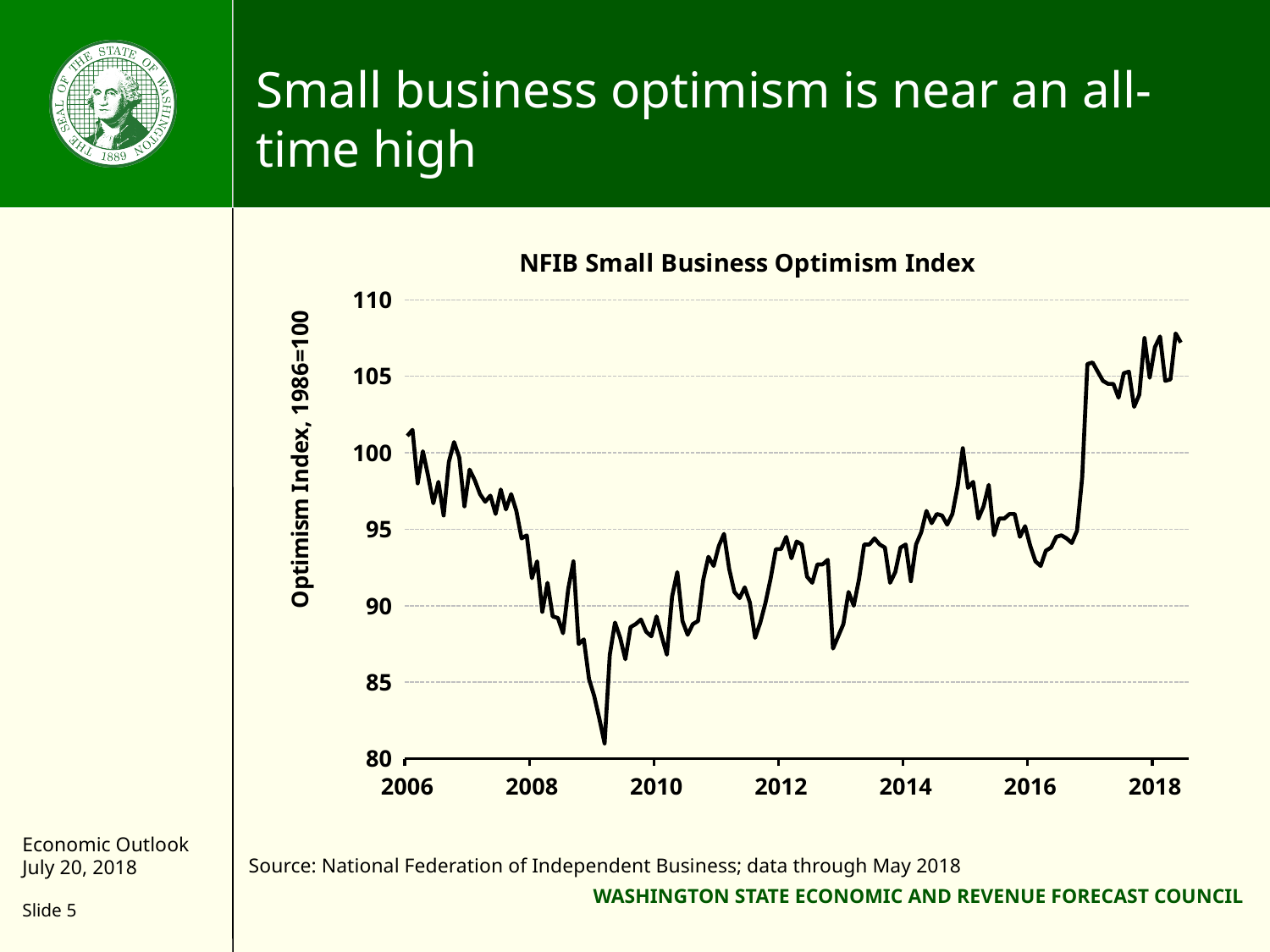
How many lines are plotted on the chart? 1 Is the value of the index at the start of 2016 greater or less than 100? less What is the label on the vertical axis of the chart? Optimism Index, 1986=100 In which year does the NFIB Small Business Optimism Index reach its lowest point on the chart? 2009 Does the index rise or fall between 2016 and 2018? rise What is the title of the chart? NFIB Small Business Optimism Index In which year does the NFIB Small Business Optimism Index reach its highest point on the chart? 2018 Is the lowest value of the index in 2009 greater or less than 85? less Is the value of the index in early 2018 greater or less than 105? greater What kind of chart is shown on the slide? Line chart Does the index rise or fall between 2007 and 2009? fall